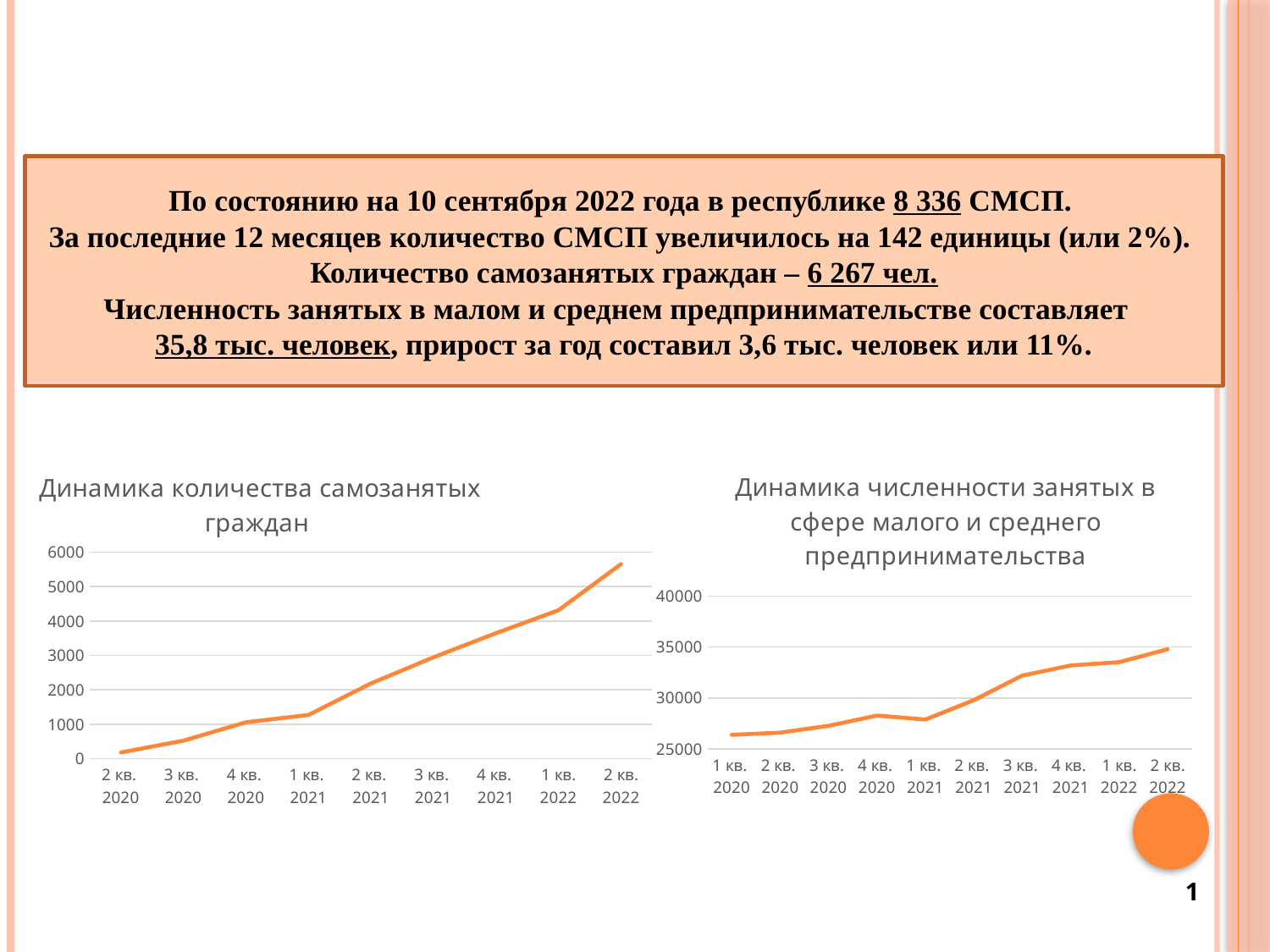
On the left chart, 'Динамика количества самозанятых граждан', is the value for 4 кв. 2021 greater or less than 3000? greater How many quarters are plotted on the right chart, 'Динамика численности занятых в сфере малого и среднего предпринимательства'? 10 How many quarters are plotted on the left chart, 'Динамика количества самозанятых граждан'? 9 What type of chart is the right chart, 'Динамика численности занятых в сфере малого и среднего предпринимательства'? line chart On the right chart, 'Динамика численности занятых в сфере малого и среднего предпринимательства', is the value for 4 кв. 2020 greater or less than 30000? less What type of chart is the left chart, 'Динамика количества самозанятых граждан'? line chart On the right chart, 'Динамика численности занятых в сфере малого и среднего предпринимательства', do the values generally rise or fall from 1 кв. 2020 to 2 кв. 2022? rise On the left chart, 'Динамика количества самозанятых граждан', which quarter has the highest value? 2 кв. 2022 On the left chart, 'Динамика количества самозанятых граждан', is the value for 2 кв. 2022 greater or less than 5000? greater On the right chart, 'Динамика численности занятых в сфере малого и среднего предпринимательства', which quarter has the lowest value? 1 кв. 2020 On the left chart, 'Динамика количества самозанятых граждан', do the values rise or fall from 2 кв. 2020 to 2 кв. 2022? rise